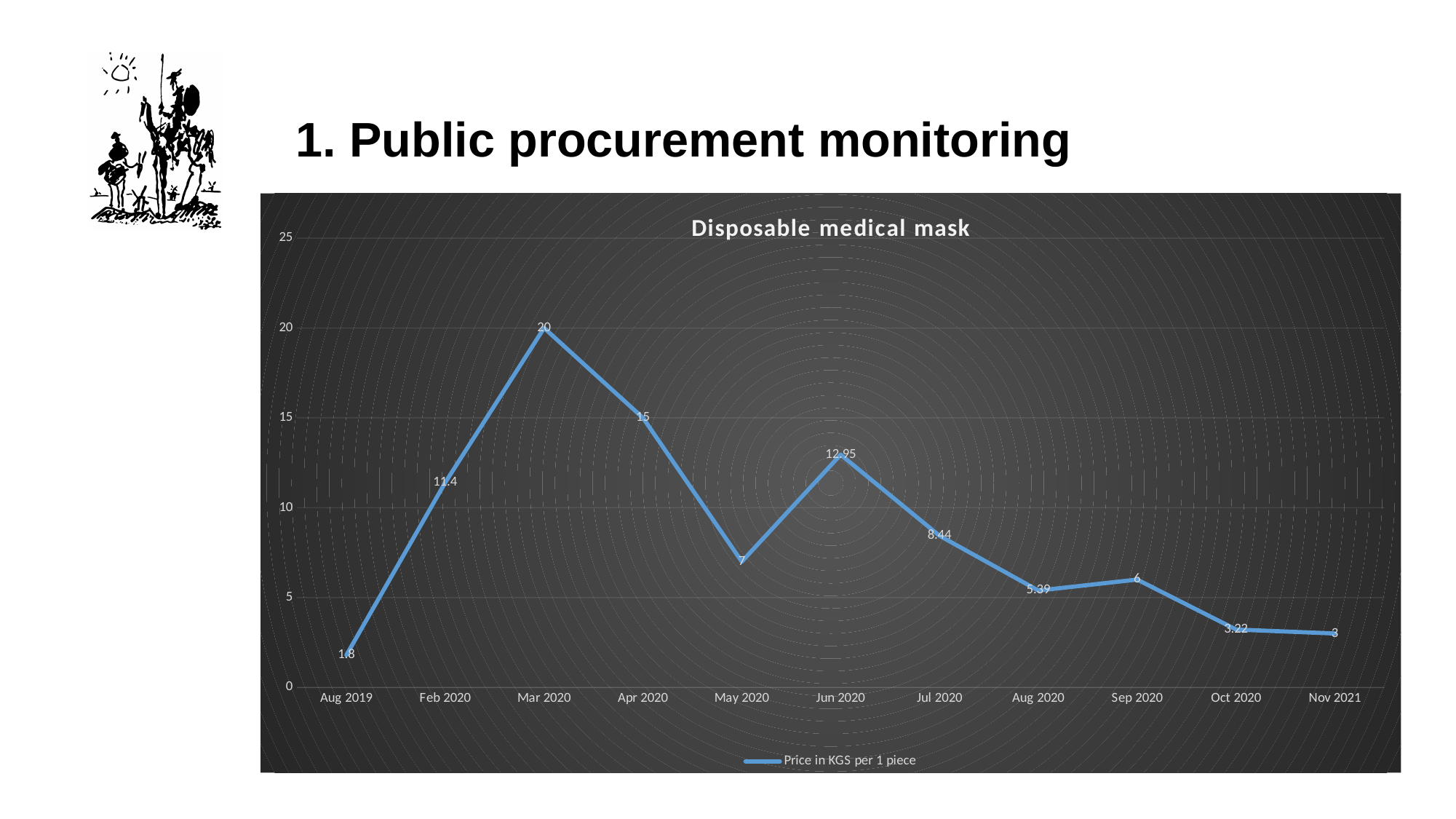
What is the title of the chart? Disposable medical mask What is the price in KGS per 1 piece for Mar 2020? 20 What kind of chart is shown on the slide? line chart What is the difference between the price in Mar 2020 and the price in Apr 2020? 5 Which month has the lowest price in KGS per 1 piece? Aug 2019 What is the price in KGS per 1 piece for Aug 2019? 1.8 Is the price for Feb 2020 greater or less than 10? greater What is the price in KGS per 1 piece for Jun 2020? 12.95 Which month has the highest price in KGS per 1 piece? Mar 2020 How many months are plotted on the x axis? 11 Which is larger, the price in Jul 2020 or the price in Sep 2020? Jul 2020 How many series does the legend list? 1